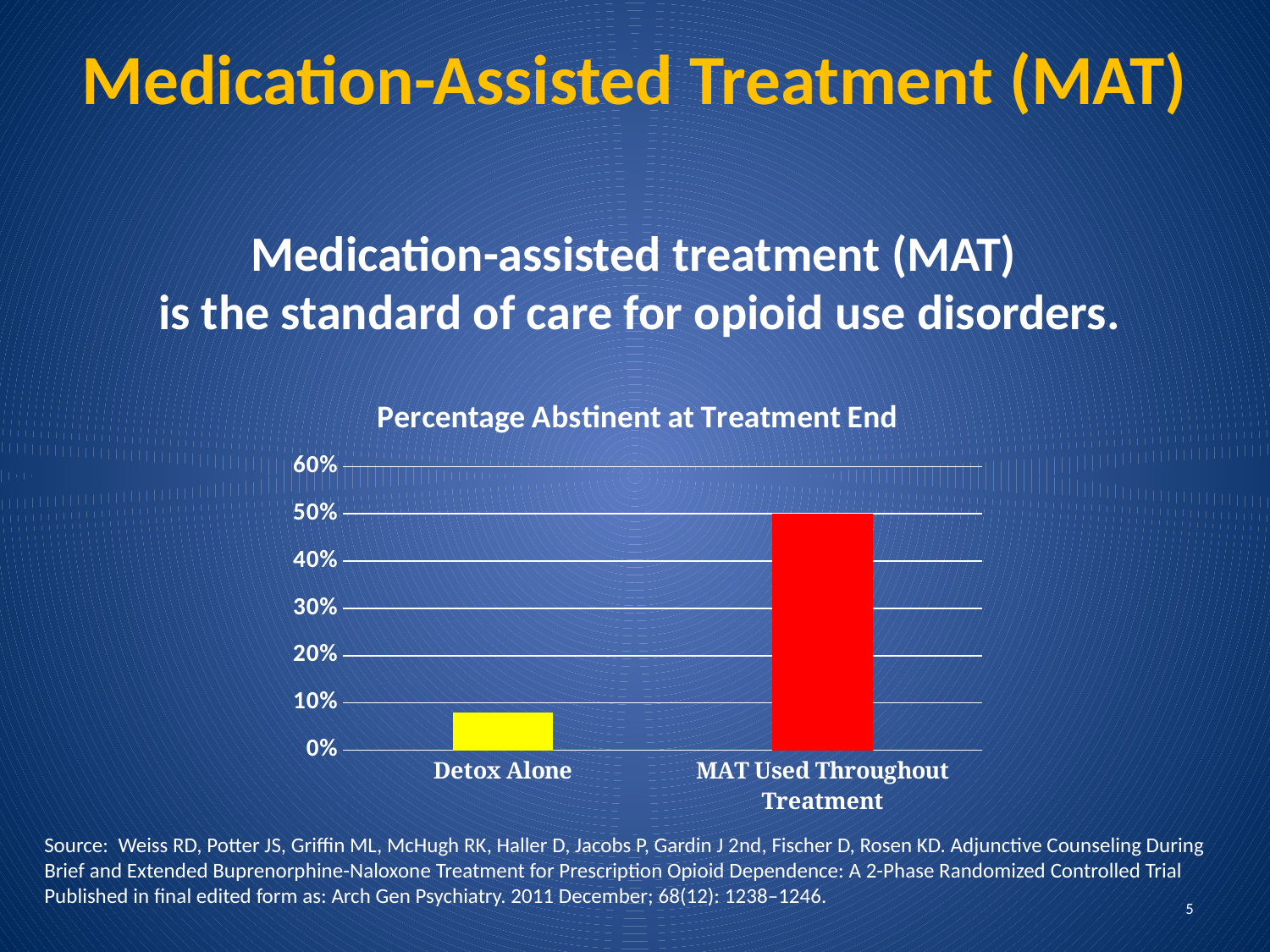
Which category has the highest percentage abstinent at treatment end? MAT Used Throughout Treatment What is the highest value shown on the chart's y axis? 60% Is the value for Detox Alone greater or less than 20%? less How many categories are shown on the chart's x axis? 2 Is the value for Detox Alone greater or less than 10%? less Is the value for MAT Used Throughout Treatment greater or less than 60%? less What is the title of the chart? Percentage Abstinent at Treatment End Which is larger, the value for Detox Alone or the value for MAT Used Throughout Treatment? MAT Used Throughout Treatment What kind of chart is shown on the slide? bar chart Which category has the lowest percentage abstinent at treatment end? Detox Alone What colour is the bar for Detox Alone? yellow